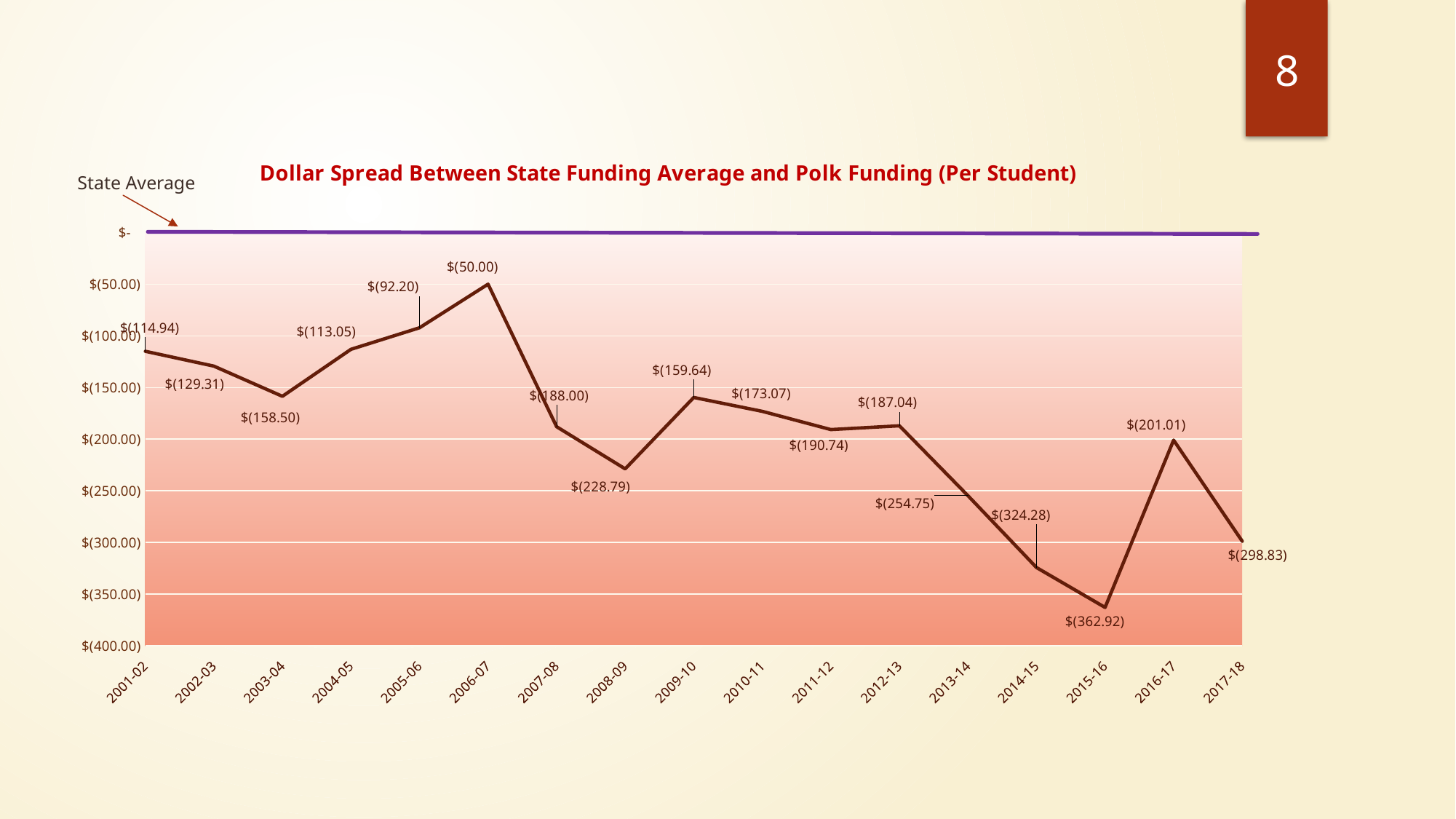
Which year's point is farther below the State Average line, 2008-09 or 2009-10? 2008-09 Overall, does the Polk funding spread move closer to or farther from the State Average line from 2001-02 to 2017-18? Farther What is the value shown for 2015-16? $(362.92) What is the value shown for 2006-07? $(50.00) How many school years are plotted along the x axis? 17 Which school year has the point closest to the State Average line (the smallest dollar spread)? 2006-07 What kind of chart is shown on the slide? Line chart Which school year has the point farthest below the State Average line (the largest dollar spread)? 2015-16 By how many dollars does the spread change between 2015-16 and 2016-17? $161.91 What is the title of the chart? Dollar Spread Between State Funding Average and Polk Funding (Per Student) What is the value shown for 2017-18? $(298.83) What is the value shown for 2001-02? $(114.94)